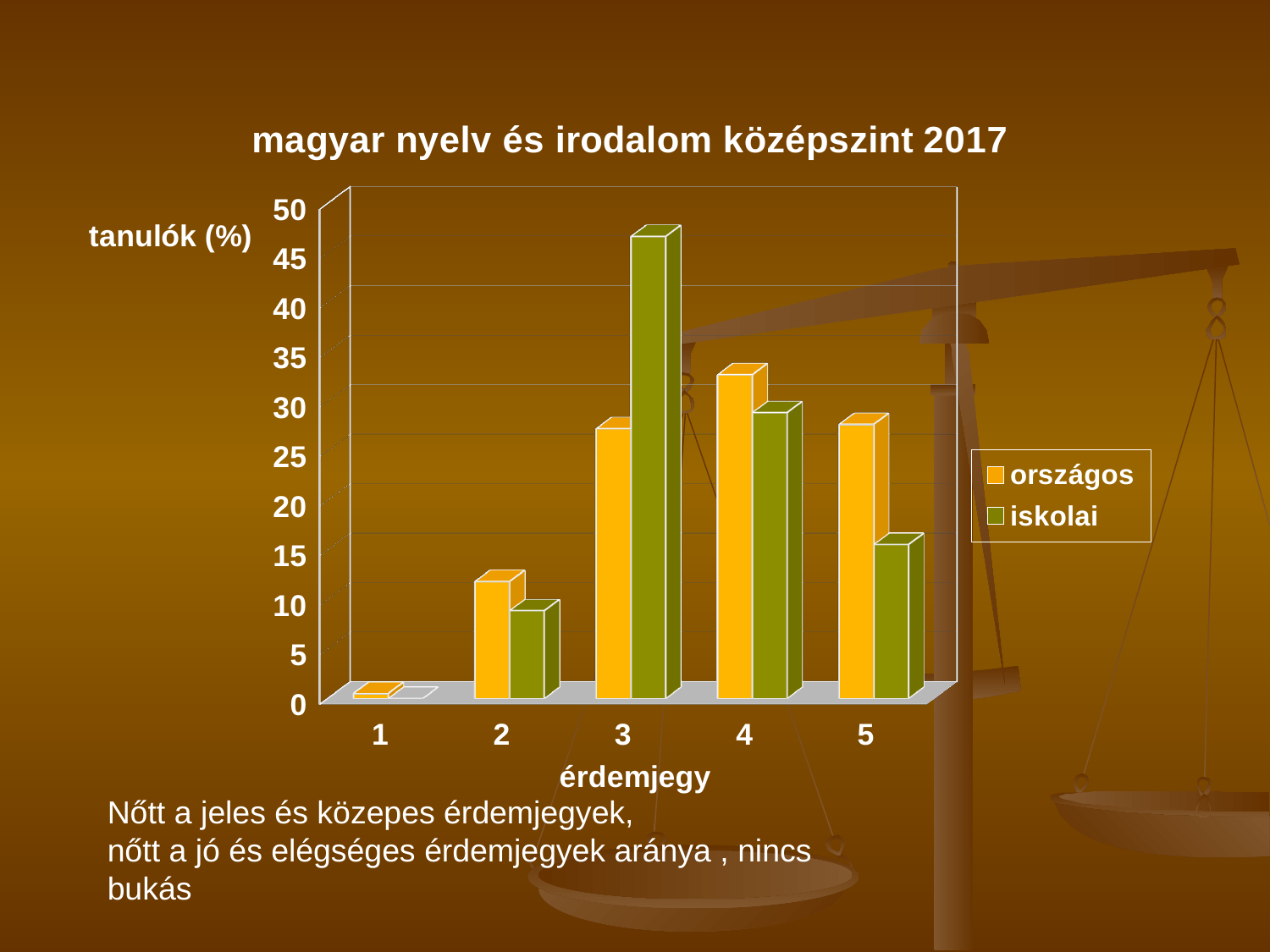
How many grade categories (érdemjegy) are shown on the x axis? 5 Is the iskolai value for grade 3 greater or less than 40? greater Is the iskolai value for grade 5 greater or less than 20? less For which grade is the országos value lowest? 1 For grade 5, which series has the larger value, országos or iskolai? országos For which grade is the iskolai value highest? 3 Is the országos value for grade 4 greater or less than 30? greater What is the title of the chart? magyar nyelv és irodalom középszint 2017 How many series does the legend list? 2 For which grade is the országos value highest? 4 What kind of chart is shown on the slide? bar chart